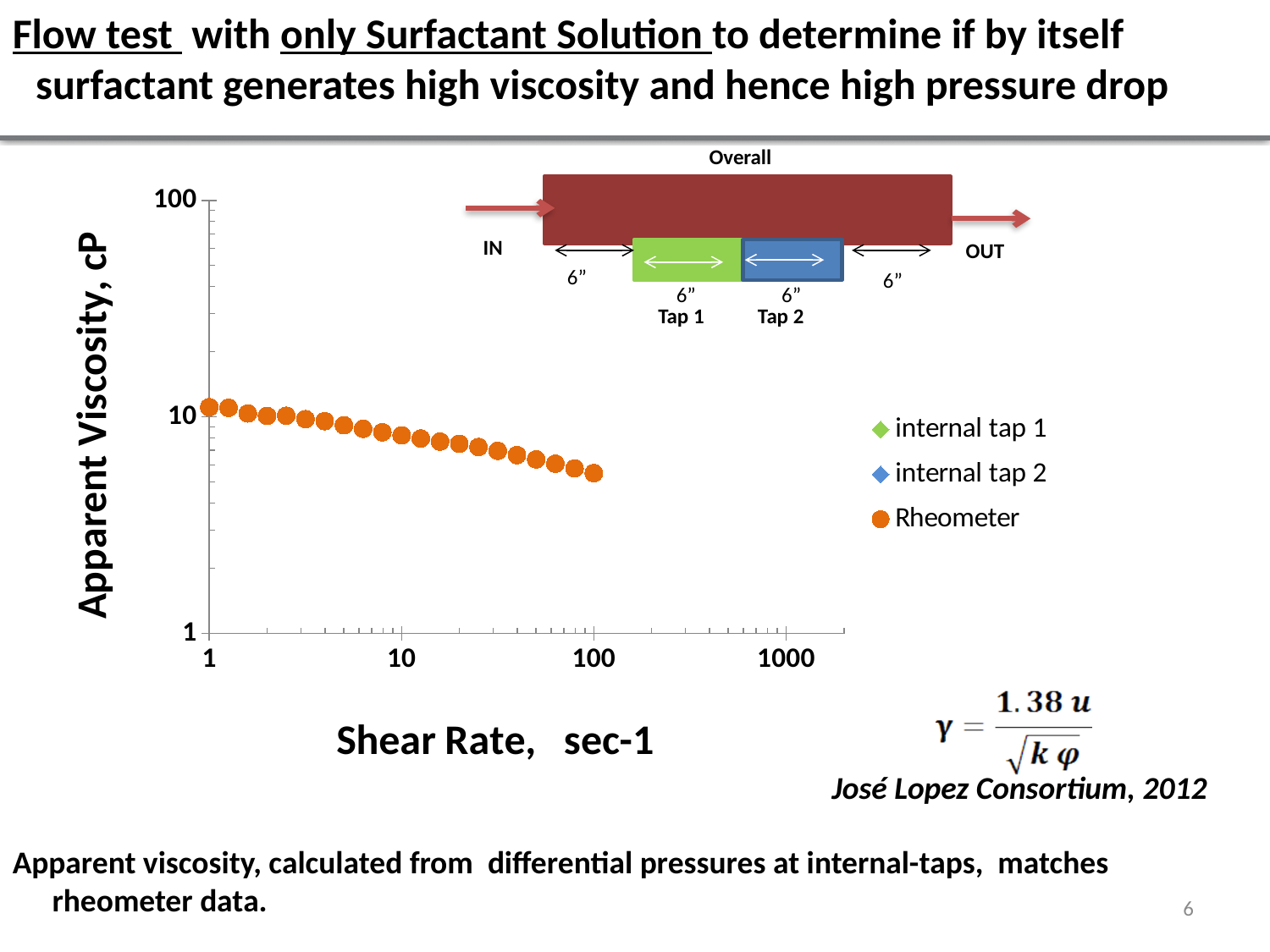
What kind of chart is shown on the slide? scatter chart What is the label of the chart's y axis? Apparent Viscosity, cP Is the Rheometer apparent viscosity at a shear rate of 100 sec-1 greater or less than 10 cP? less How many series does the chart legend list? 3 Does the apparent viscosity rise or fall as the shear rate increases along the x axis? fall Is the Rheometer apparent viscosity at a shear rate of 10 sec-1 greater or less than 100 cP? less Which series in the legend is shown with orange circle markers? Rheometer Is the Rheometer apparent viscosity at a shear rate of 100 sec-1 greater or less than 1 cP? greater